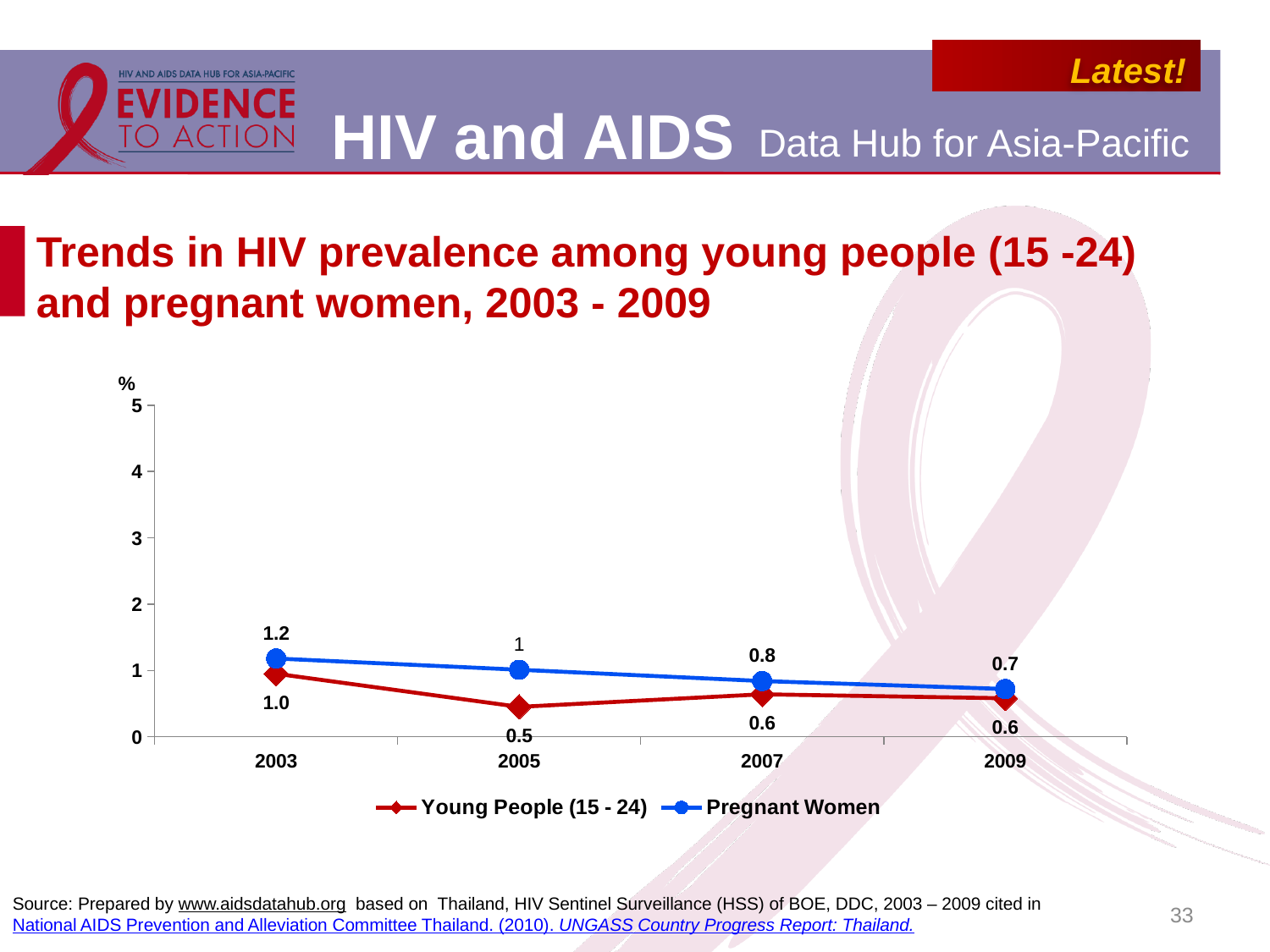
What was the HIV prevalence among Pregnant Women in 2005? 1 In which year was HIV prevalence among Pregnant Women highest? 2003 In which year was HIV prevalence among Young People (15 - 24) lowest? 2005 What was the HIV prevalence among Young People (15 - 24) in 2005? 0.5 What was the HIV prevalence among Pregnant Women in 2009? 0.7 What was the HIV prevalence among Young People (15 - 24) in 2003? 1.0 Does HIV prevalence among Pregnant Women rise or fall from 2003 to 2009? Fall What type of chart is shown on the slide? Line chart What is the difference between the Pregnant Women and Young People (15 - 24) values in 2003? 0.2 How many series does the legend list? 2 Which series had the higher value in 2005, Young People (15 - 24) or Pregnant Women? Pregnant Women How many years are plotted on the x axis? 4